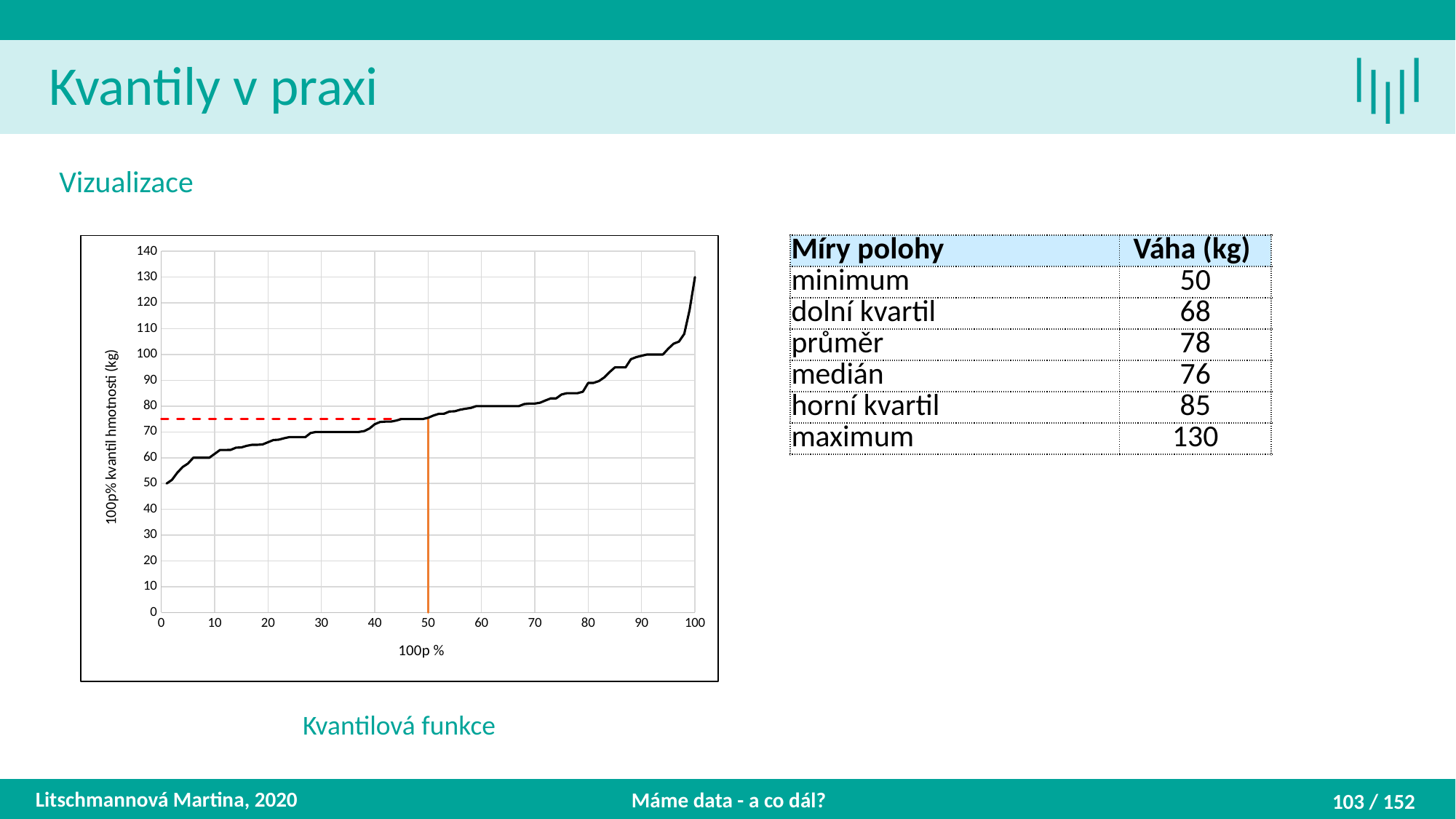
What is the title of the x axis of the chart? 100p % Is the value of the quantile function at 100p % = 50 greater or less than 70? greater What is the caption written below the chart? Kvantilová funkce Is the value of the quantile function at 100p % = 10 greater or less than 70? less Is the value of the quantile function at 100p % = 90 greater or less than 90? greater What is the value of the quantile function at 100p % = 100? 130 What kind of chart is shown on the slide? line chart What is the highest value shown on the y axis of the chart? 140 Do the values on the chart rise or fall as 100p % increases from 0 to 100? rise What is the value of the quantile function at 100p % = 0? 50